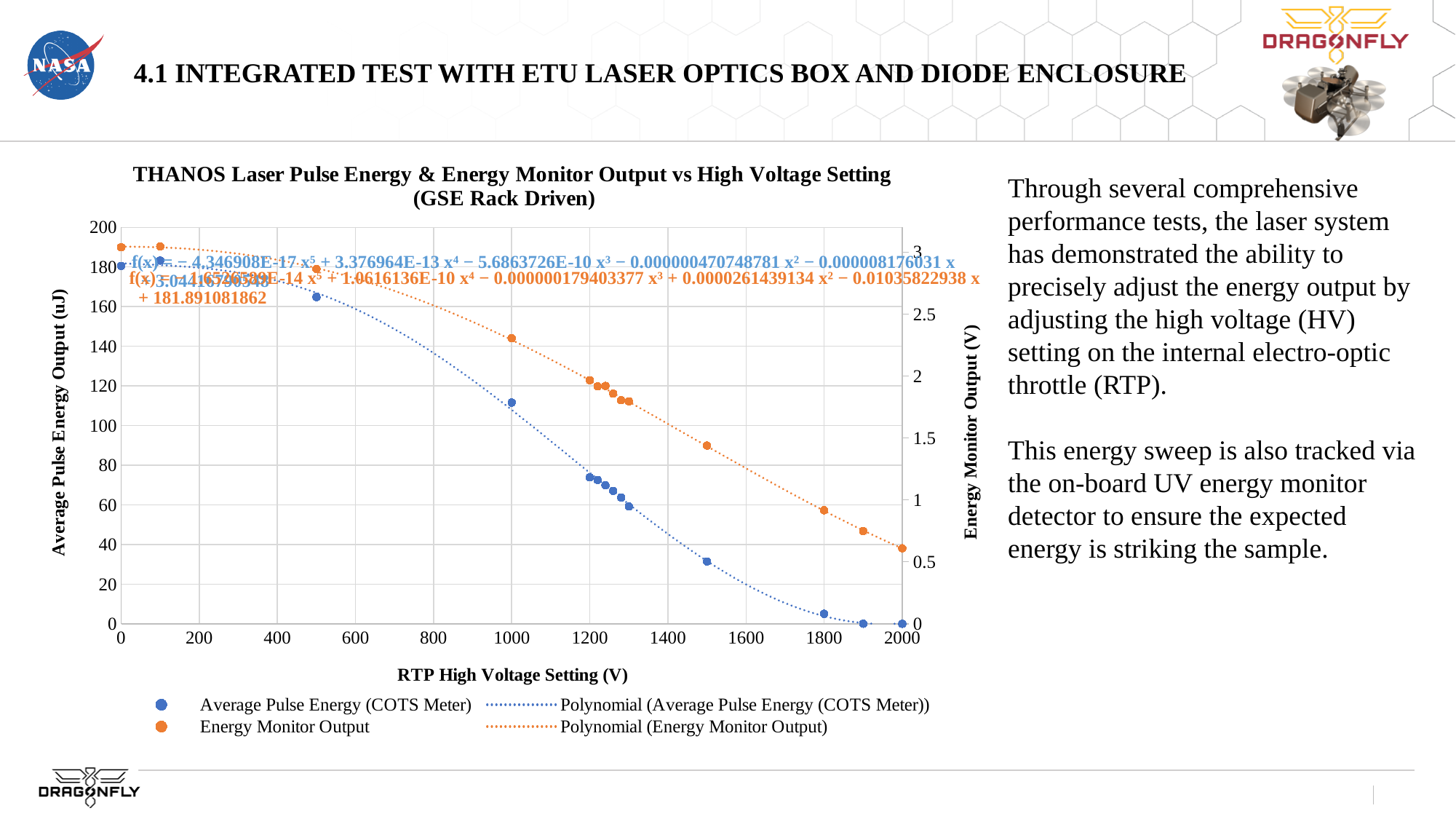
Is the Average Pulse Energy (COTS Meter) at an RTP setting of 1000 V greater or less than 100 uJ? greater Which is larger, the Average Pulse Energy (COTS Meter) at 1000 V or at 1500 V? 1000 V As the RTP high voltage setting increases, does the Energy Monitor Output rise or fall? Fall Is the Average Pulse Energy (COTS Meter) at an RTP setting of 500 V greater or less than 160 uJ? greater What is the label of the x axis? RTP High Voltage Setting (V) Is the Average Pulse Energy (COTS Meter) at an RTP setting of 1500 V greater or less than 40 uJ? less As the RTP high voltage setting increases, does the Average Pulse Energy (COTS Meter) rise or fall? Fall How many entries does the chart legend list? 4 What kind of chart is shown on the slide? Scatter chart What is the title of the chart? THANOS Laser Pulse Energy & Energy Monitor Output vs High Voltage Setting (GSE Rack Driven)